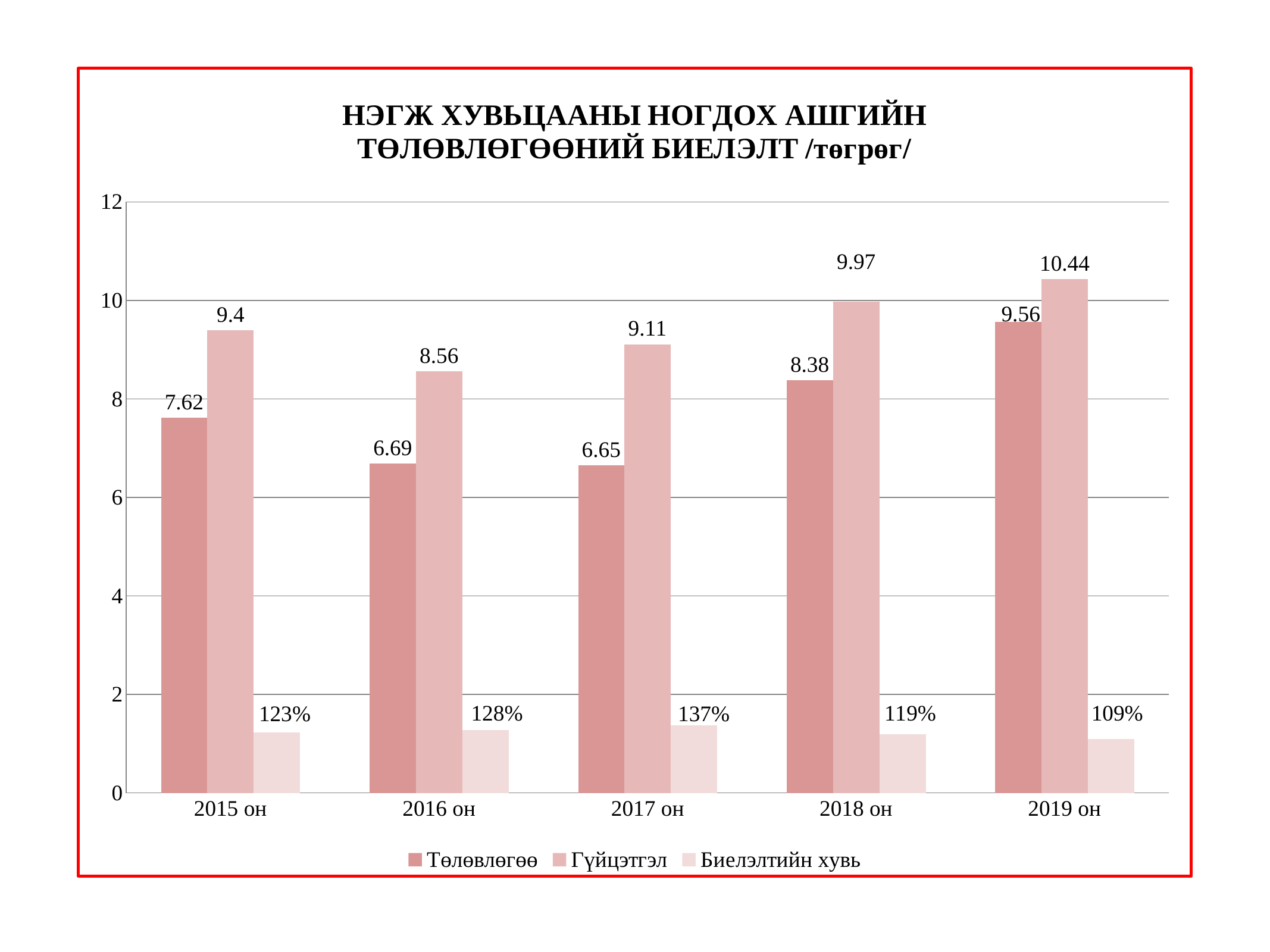
Which year has the lowest Биелэлтийн хувь value? 2019 он How many years are shown on the x axis? 5 What is the Төлөвлөгөө value for 2017 он? 6.65 What kind of chart is shown on the slide? Bar chart Which year has the highest Гүйцэтгэл value? 2019 он What is the difference between the Гүйцэтгэл and Төлөвлөгөө values for 2015 он? 1.78 How many series does the legend list? 3 Which year has the lowest Төлөвлөгөө value? 2017 он Which is larger: the Төлөвлөгөө value for 2019 он or the Гүйцэтгэл value for 2016 он? Төлөвлөгөө for 2019 он What is the Биелэлтийн хувь value for 2016 он? 128% Does the Гүйцэтгэл value rise or fall from 2016 он to 2019 он? Rise What is the Гүйцэтгэл value for 2018 он? 9.97